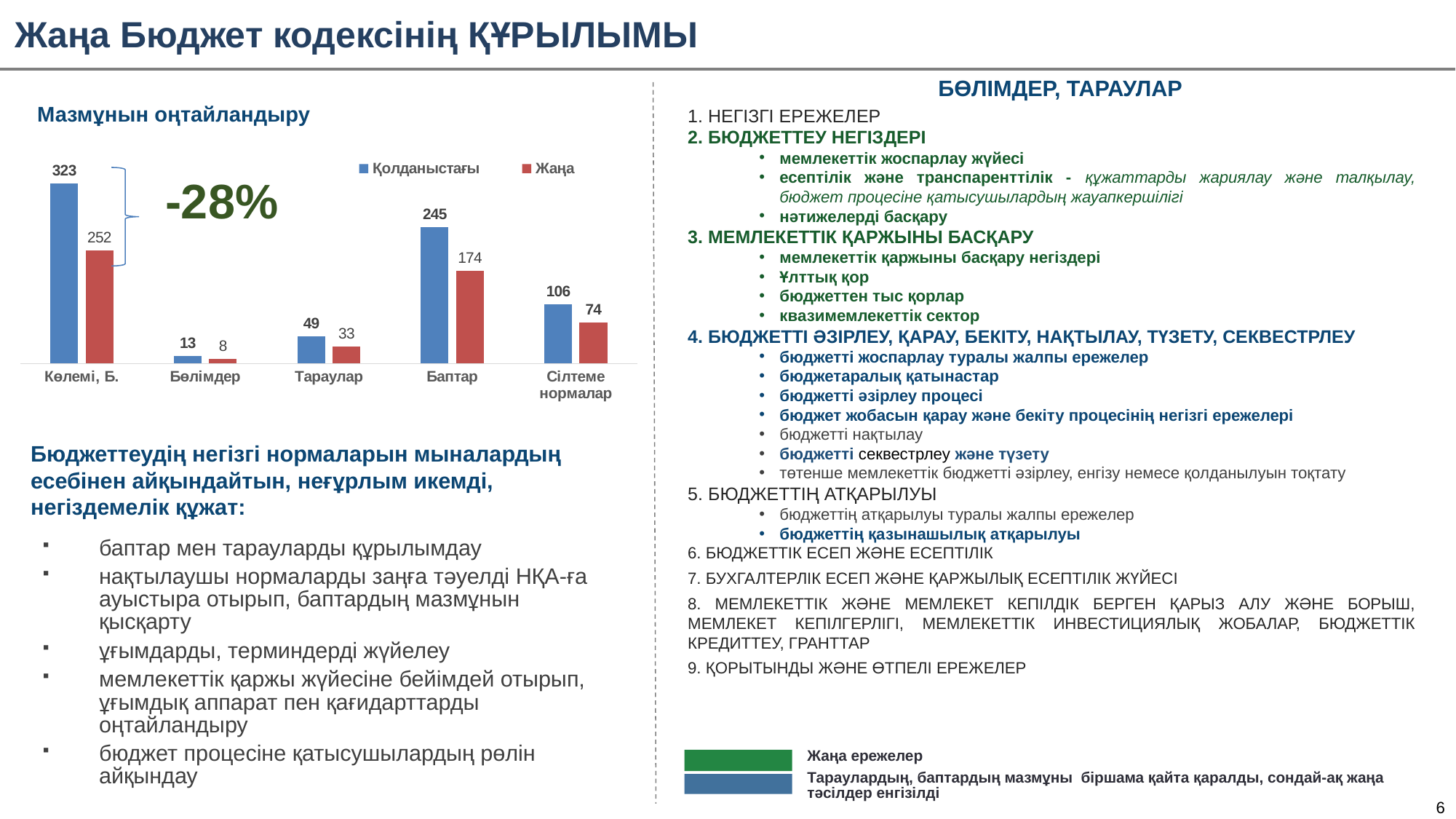
What are the two series named in the chart legend? Қолданыстағы and Жаңа Which category has the highest "Қолданыстағы" value? Көлемі, Б. Which category has the lowest "Жаңа" value? Бөлімдер Which is larger for "Баптар": the "Қолданыстағы" value or the "Жаңа" value? Қолданыстағы What type of chart is shown under the heading "Мазмұнын оңтайландыру"? bar chart What is the difference between the "Қолданыстағы" and "Жаңа" values for "Тараулар"? 16 How many series does the chart legend list? 2 What is the value of "Қолданыстағы" for "Көлемі, Б."? 323 What is the value of "Жаңа" for "Бөлімдер"? 8 What is the value of "Жаңа" for "Баптар"? 174 How many categories are shown on the x axis of the chart? 5 What is the value of "Қолданыстағы" for "Сілтеме нормалар"? 106